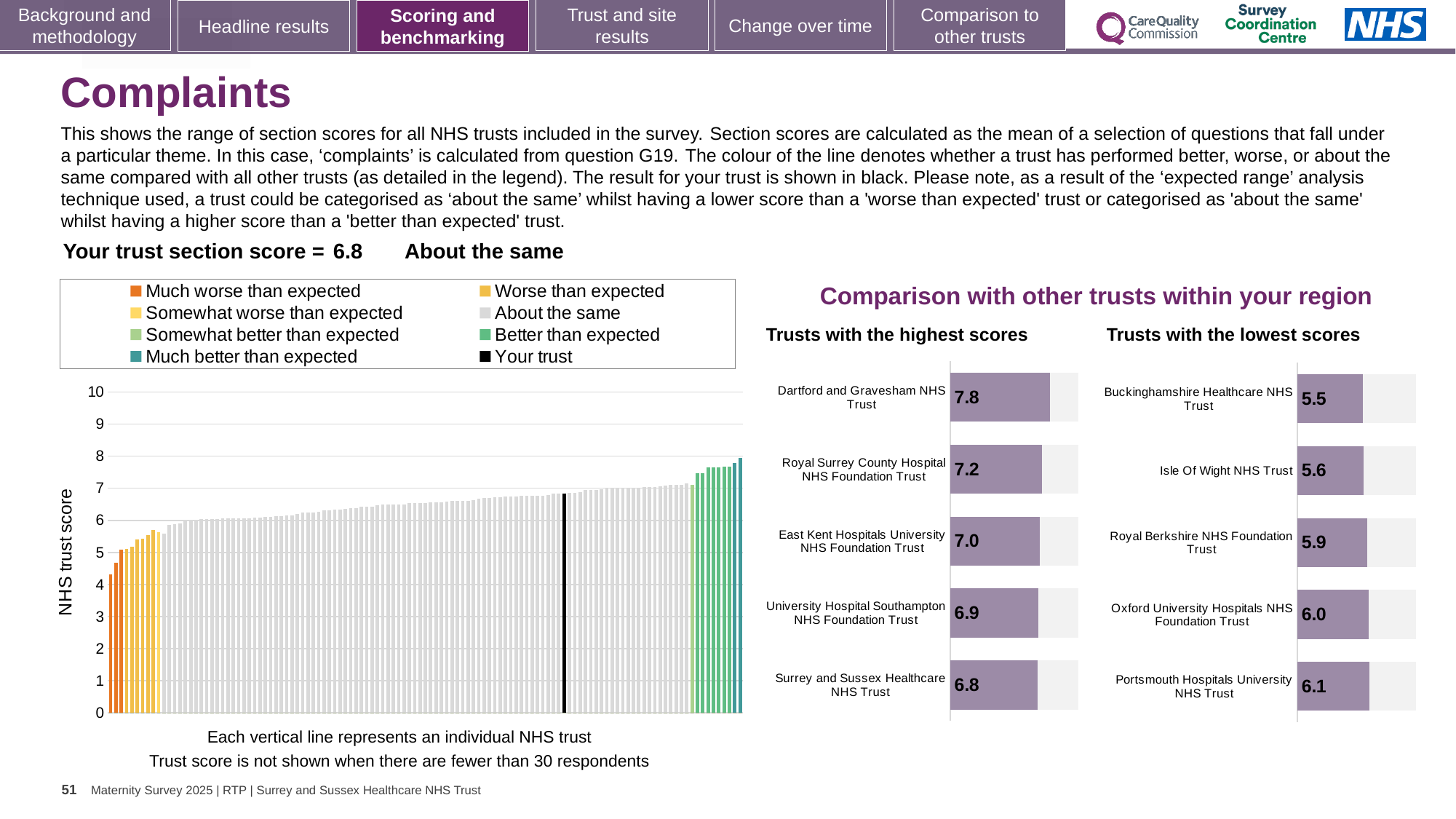
In the 'NHS trust score' chart, is the value of the lowest (leftmost) bar greater or less than 5? less In the 'Trusts with the highest scores' chart, which trust has the highest score? Dartford and Gravesham NHS Trust In the 'Trusts with the highest scores' chart, what is the difference between the scores of Dartford and Gravesham NHS Trust and Surrey and Sussex Healthcare NHS Trust? 1.0 What kind of chart is the 'NHS trust score' chart on the left of the slide? Bar chart In the 'Trusts with the lowest scores' chart, what is the difference between the scores of Portsmouth Hospitals University NHS Trust and Buckinghamshire Healthcare NHS Trust? 0.6 In the 'Trusts with the lowest scores' chart, which trust has the lowest score? Buckinghamshire Healthcare NHS Trust How many trusts are shown in the 'Trusts with the lowest scores' chart? 5 In the 'Trusts with the highest scores' chart, what is the score for Dartford and Gravesham NHS Trust? 7.8 In the 'NHS trust score' chart, do the bar values rise or fall from left to right along the x axis? Rise In the 'Trusts with the lowest scores' chart, what is the score for Royal Berkshire NHS Foundation Trust? 5.9 In the 'Trusts with the highest scores' chart, which has a higher score: Royal Surrey County Hospital NHS Foundation Trust or University Hospital Southampton NHS Foundation Trust? Royal Surrey County Hospital NHS Foundation Trust How many entries does the legend of the 'NHS trust score' chart list? 8